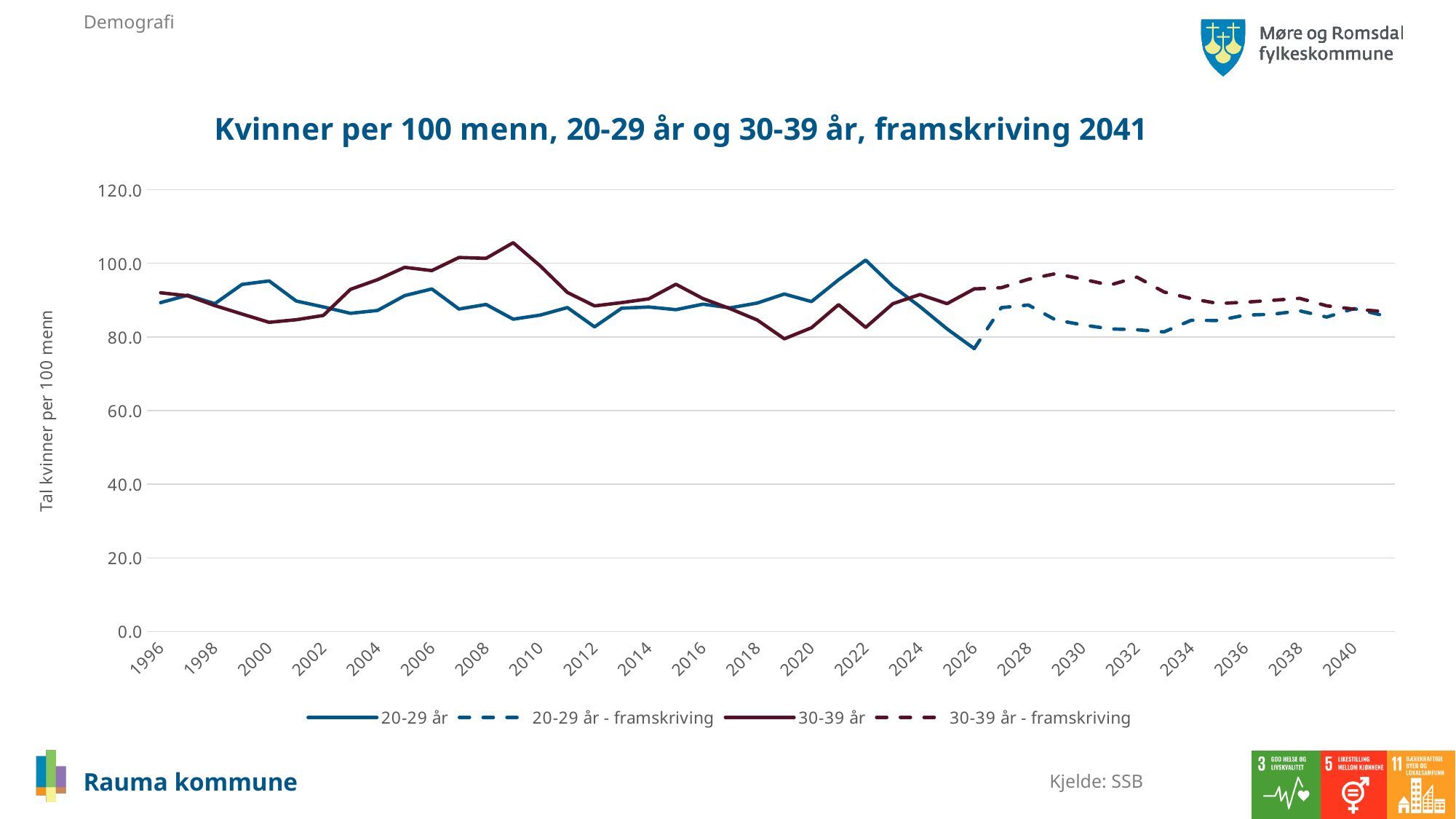
What kind of chart is shown on the slide? Line chart Is the value for the 30-39 år series in 2009 greater or less than 100? greater In 2009, which series has the larger value, 20-29 år or 30-39 år? 30-39 år In 2022, which series has the larger value, 20-29 år or 30-39 år? 20-29 år What is the label on the vertical axis? Tal kvinner per 100 menn Does the 20-29 år series rise or fall between 2022 and 2026? Fall What is the title of the chart? Kvinner per 100 menn, 20-29 år og 30-39 år, framskriving 2041 How many series does the legend list? 4 In which year does the 20-29 år series reach its lowest value? 2026 Is the value for the 20-29 år series in 2026 greater or less than 80? less Is the value for the 20-29 år series in 2012 greater or less than 80? greater In which year does the 30-39 år series reach its highest value? 2009